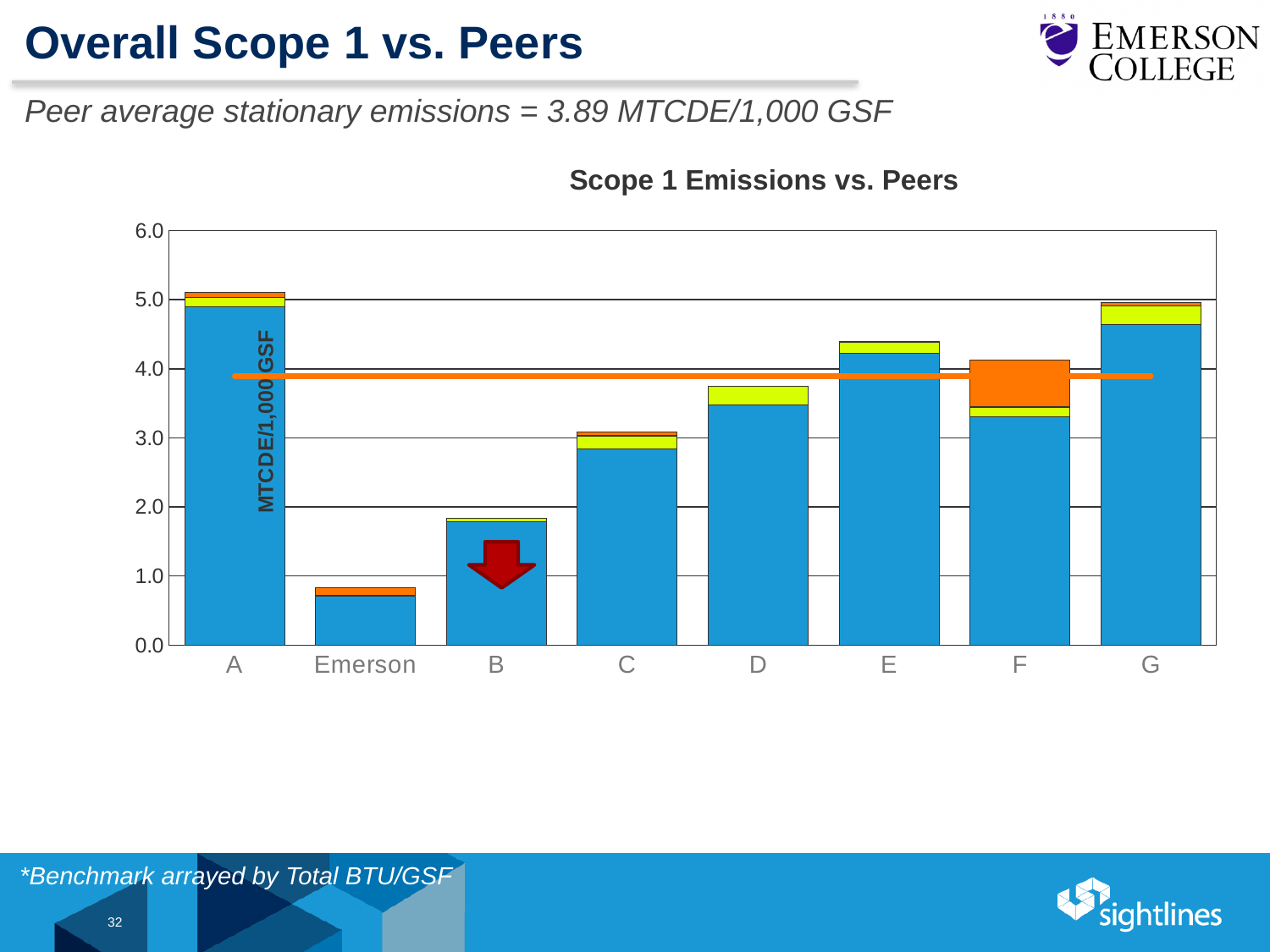
What is the title of the chart? Scope 1 Emissions vs. Peers Which has the larger total bar, D or E? E Is the total value for B greater or less than 2.0? less Is the total value for Emerson greater or less than 1.0? less Which category has the lowest total bar in the chart? Emerson What kind of chart is shown on the slide? bar chart How many categories are shown along the x axis of the chart? 8 Is the total value for A greater or less than 5.0? greater What is the label on the vertical axis of the chart? MTCDE/1,000 GSF Which category has the highest total bar in the chart? A Which has the larger total bar, B or C? C